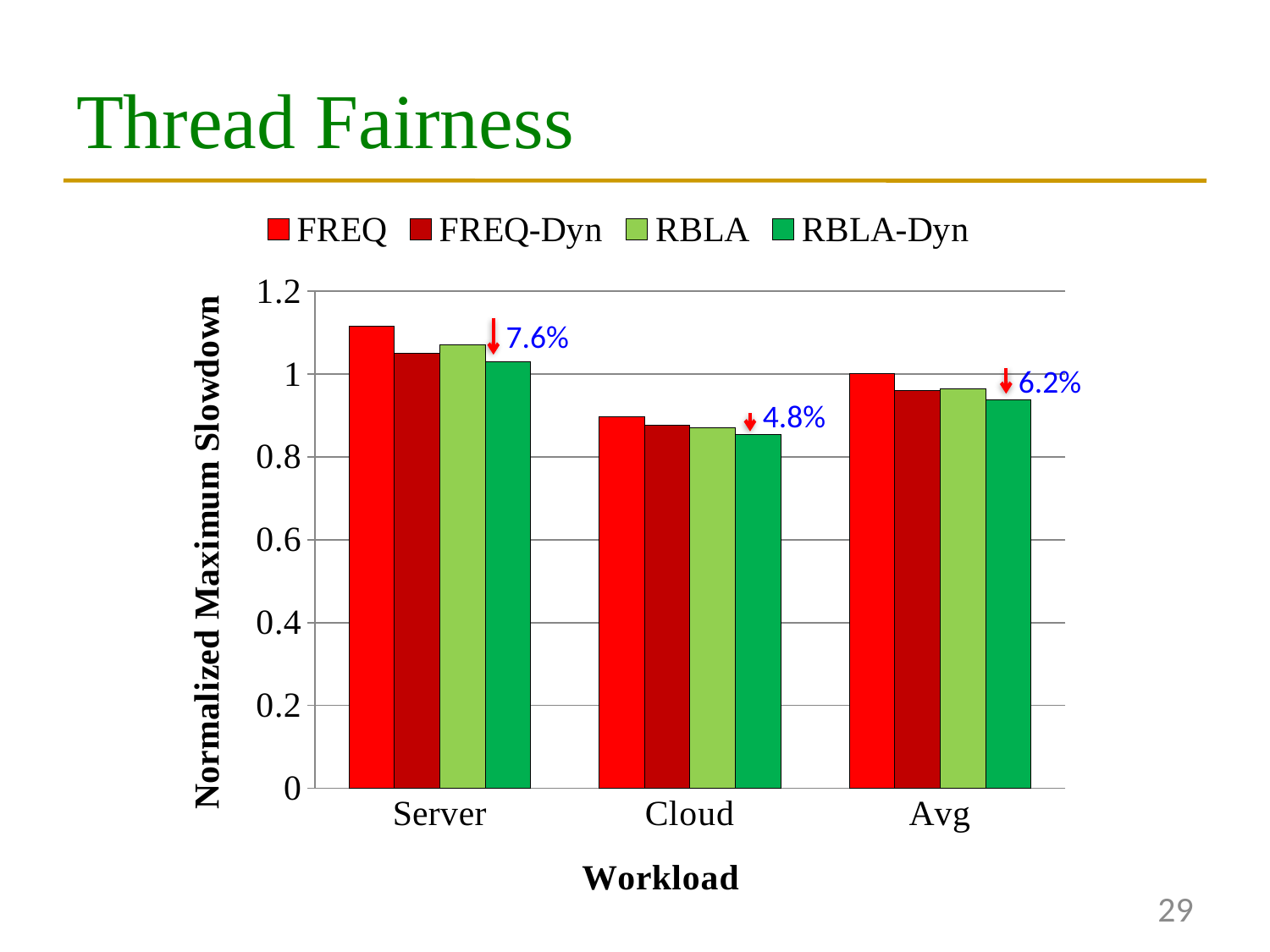
Is the value for FREQ in the Cloud workload greater or less than 1? less Which series has the highest value in the Server workload? FREQ What is the Normalized Maximum Slowdown for FREQ in the Avg workload? 1 Is the value for RBLA-Dyn in the Cloud workload greater or less than 0.8? greater Is the value for RBLA-Dyn in the Avg workload greater or less than 1? less How many series does the legend list? 4 What percentage reduction is annotated above the Server workload bars? 7.6% Which is larger, the FREQ value for Server or the FREQ value for Cloud? Server What is the label of the y axis? Normalized Maximum Slowdown How many workload categories are shown on the x axis? 3 What kind of chart is shown on the slide? bar chart